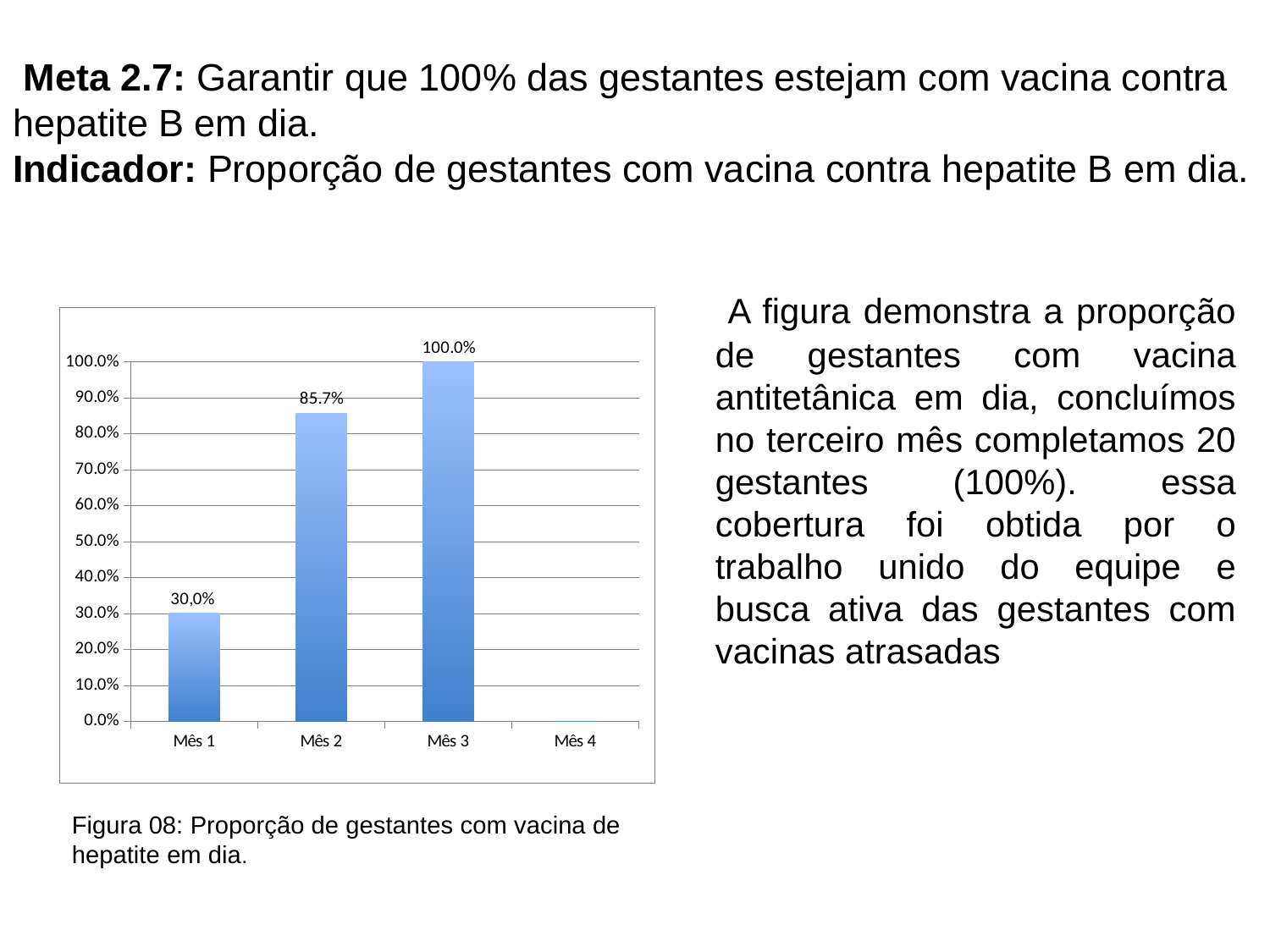
What kind of chart is shown? bar chart Which is larger, the value for Mês 1 or the value for Mês 2? Mês 2 Do the values rise or fall from Mês 1 to Mês 3? rise What is the value shown for Mês 2? 85.7% Which month has the highest value? Mês 3 What is the difference between the values for Mês 2 and Mês 1? 55.7% What is the value shown for Mês 3? 100.0% How many months are shown on the x axis? 4 What is the value shown for Mês 1? 30,0% Is the value for Mês 1 greater or less than 40.0%? less Which month has the lowest value? Mês 4 What is the difference between the values for Mês 3 and Mês 2? 14.3%